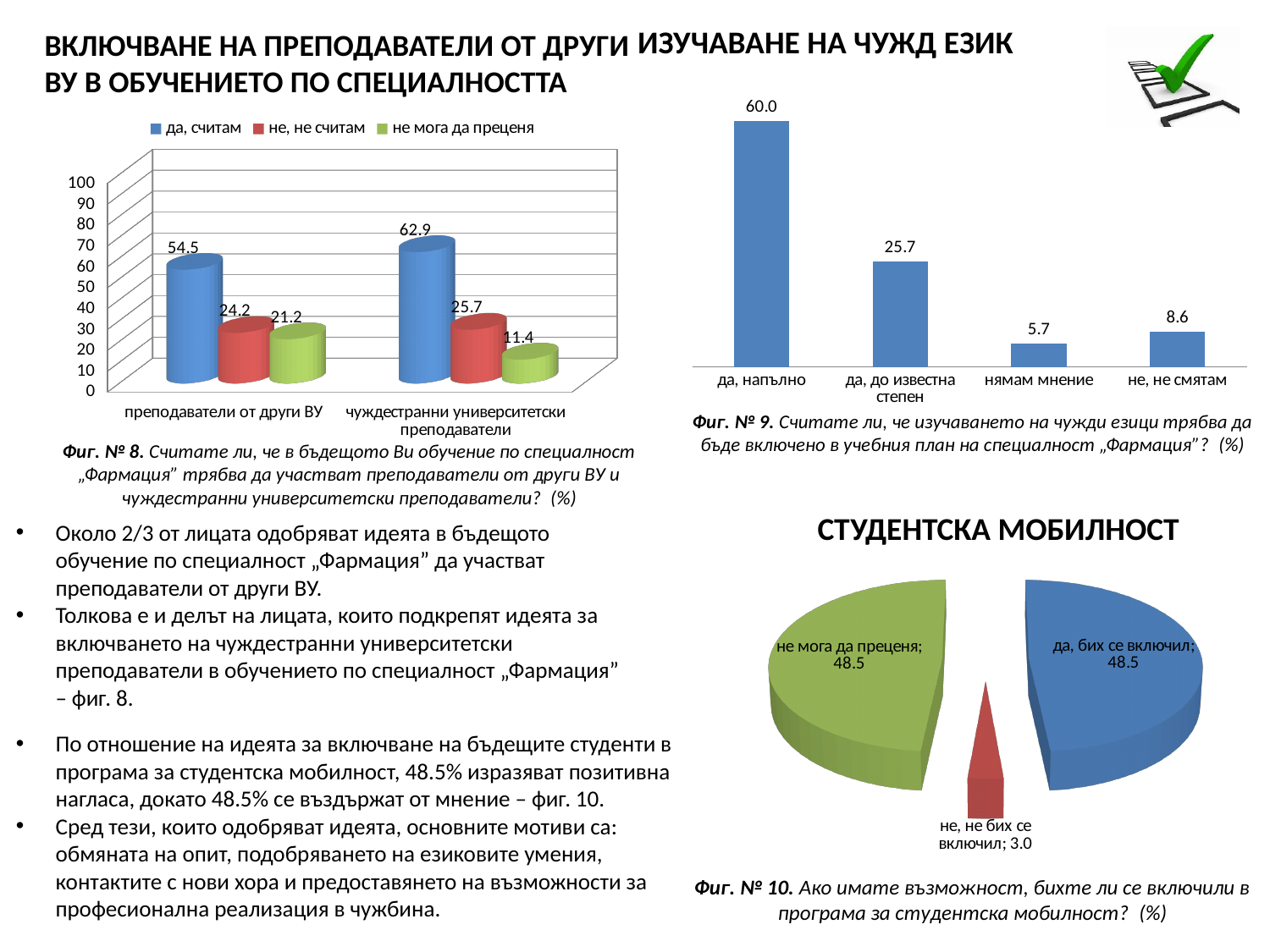
In the chart 'СТУДЕНТСКА МОБИЛНОСТ' (Фиг. № 10), what is the value for 'не, не бих се включил'? 3.0 In the chart 'ВКЛЮЧВАНЕ НА ПРЕПОДАВАТЕЛИ ОТ ДРУГИ ВУ В ОБУЧЕНИЕТО ПО СПЕЦИАЛНОСТТА' (Фиг. № 8), what is the value for 'да, считам' for 'чуждестранни университетски преподаватели'? 62.9 In the chart 'ИЗУЧАВАНЕ НА ЧУЖД ЕЗИК' (Фиг. № 9), which category has the lowest value? нямам мнение What kind of chart is 'ИЗУЧАВАНЕ НА ЧУЖД ЕЗИК' (Фиг. № 9)? bar chart In the chart 'СТУДЕНТСКА МОБИЛНОСТ' (Фиг. № 10), which is larger: 'да, бих се включил' or 'не, не бих се включил'? да, бих се включил How many series does the legend list in the chart 'ВКЛЮЧВАНЕ НА ПРЕПОДАВАТЕЛИ ОТ ДРУГИ ВУ В ОБУЧЕНИЕТО ПО СПЕЦИАЛНОСТТА' (Фиг. № 8)? 3 In the chart 'ИЗУЧАВАНЕ НА ЧУЖД ЕЗИК' (Фиг. № 9), which category has the highest value? да, напълно In the chart 'ИЗУЧАВАНЕ НА ЧУЖД ЕЗИК' (Фиг. № 9), what is the value for 'да, до известна степен'? 25.7 What kind of chart is 'СТУДЕНТСКА МОБИЛНОСТ' (Фиг. № 10)? pie chart How many categories are shown in the chart 'ИЗУЧАВАНЕ НА ЧУЖД ЕЗИК' (Фиг. № 9)? 4 In the chart 'ВКЛЮЧВАНЕ НА ПРЕПОДАВАТЕЛИ ОТ ДРУГИ ВУ В ОБУЧЕНИЕТО ПО СПЕЦИАЛНОСТТА' (Фиг. № 8), what is the value for 'не мога да преценя' for 'преподаватели от други ВУ'? 21.2 In the chart 'ВКЛЮЧВАНЕ НА ПРЕПОДАВАТЕЛИ ОТ ДРУГИ ВУ В ОБУЧЕНИЕТО ПО СПЕЦИАЛНОСТТА' (Фиг. № 8), what is the difference between the 'да, считам' values for 'чуждестранни университетски преподаватели' and 'преподаватели от други ВУ'? 8.4